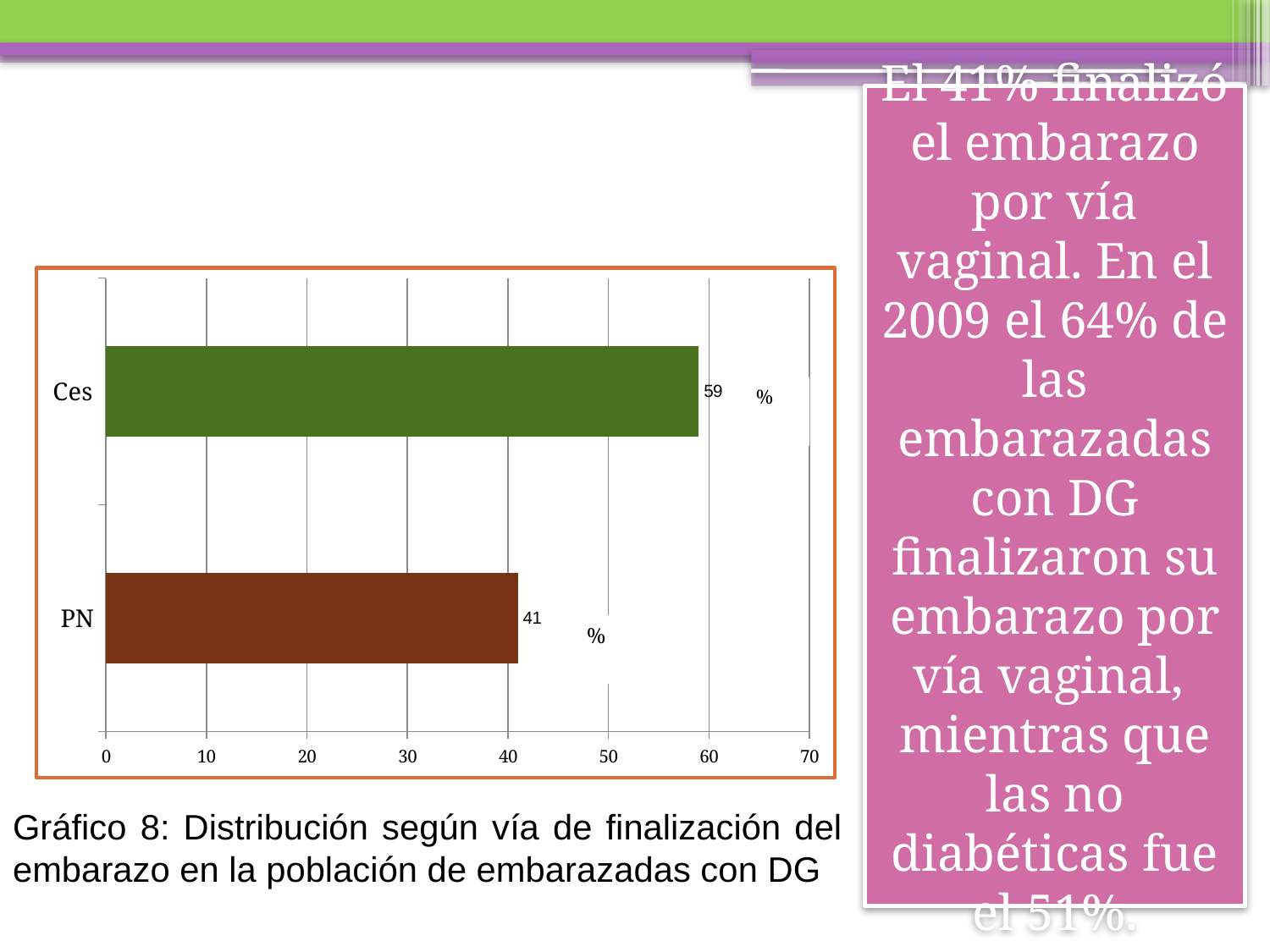
Which category has the lowest value? PN What is the value for Ces? 59 What is the maximum value shown on the horizontal axis? 70 What is the value for PN? 41 Is the value for PN greater or less than 50? less Is the value for Ces greater or less than 50? greater Which category has the highest value? Ces What colour is the bar for Ces? green What is the difference between the values for Ces and PN? 18 Which is larger, the value for Ces or the value for PN? Ces How many categories are shown in the chart? 2 What kind of chart is shown on the slide? bar chart